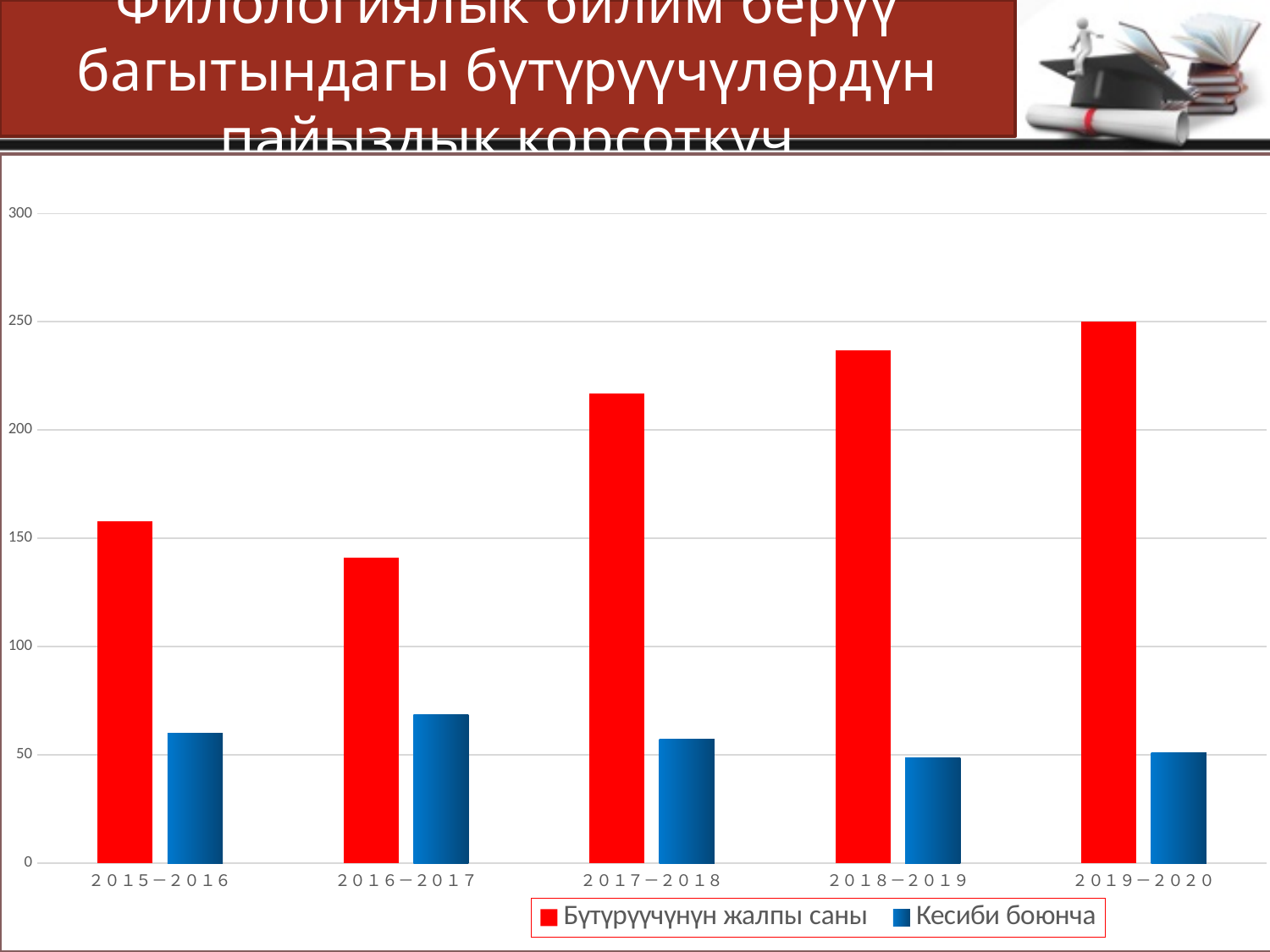
Which is larger for Бүтүрүүчүнүн жалпы саны: the value in 2017-2018 or in 2018-2019? 2018-2019 Is the value for Бүтүрүүчүнүн жалпы саны in 2017-2018 greater or less than 200? greater How many academic-year categories are shown on the x axis? 5 Is the value for Бүтүрүүчүнүн жалпы саны in 2016-2017 greater or less than 150? less In which year is the value for Кесиби боюнча the highest? 2016-2017 What kind of chart is shown on the slide? bar chart How many series does the legend list? 2 Which series is shown in red? Бүтүрүүчүнүн жалпы саны Is the value for Кесиби боюнча in 2016-2017 greater or less than 50? greater In which year is the value for Бүтүрүүчүнүн жалпы саны the lowest? 2016-2017 In which year is the value for Бүтүрүүчүнүн жалпы саны the highest? 2019-2020 Which series is shown in blue? Кесиби боюнча